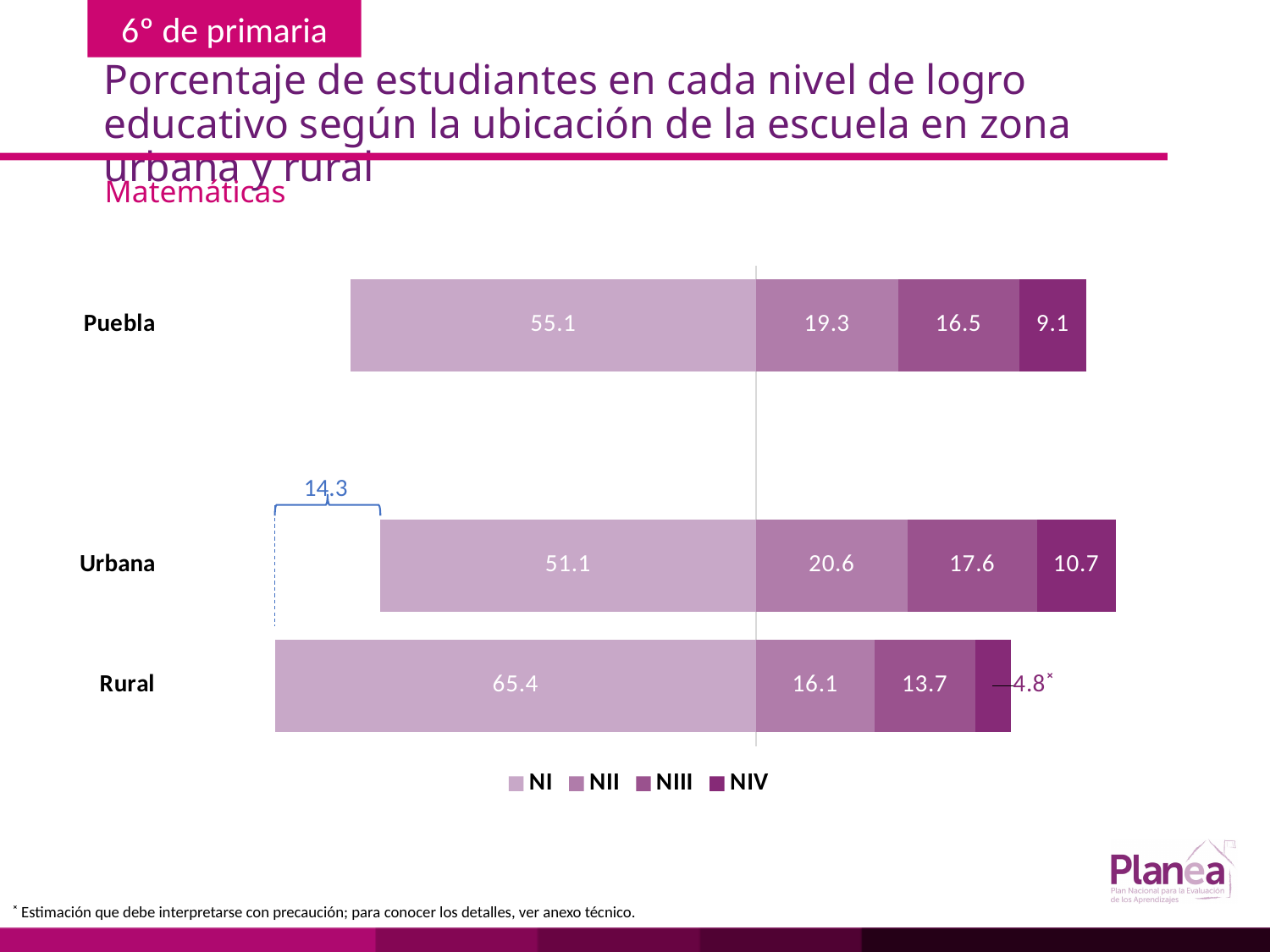
How many categories (bars) are plotted in the chart? 3 What is the NII value for Puebla? 19.3 What is the difference between the NI values for Rural and Urbana? 14.3 What is the total of the stacked bar for Puebla? 100.0 What kind of chart is shown on the slide? Stacked bar chart Which category has the highest NI value? Rural What are the legend entries of the chart, in order? NI, NII, NIII, NIV Which category has the lowest NIV value? Rural What is the NIV value for Urbana? 10.7 Which is larger, the NIII value for Urbana or the NIII value for Puebla? Urbana How many series does the legend list? 4 What is the NI value for Rural? 65.4